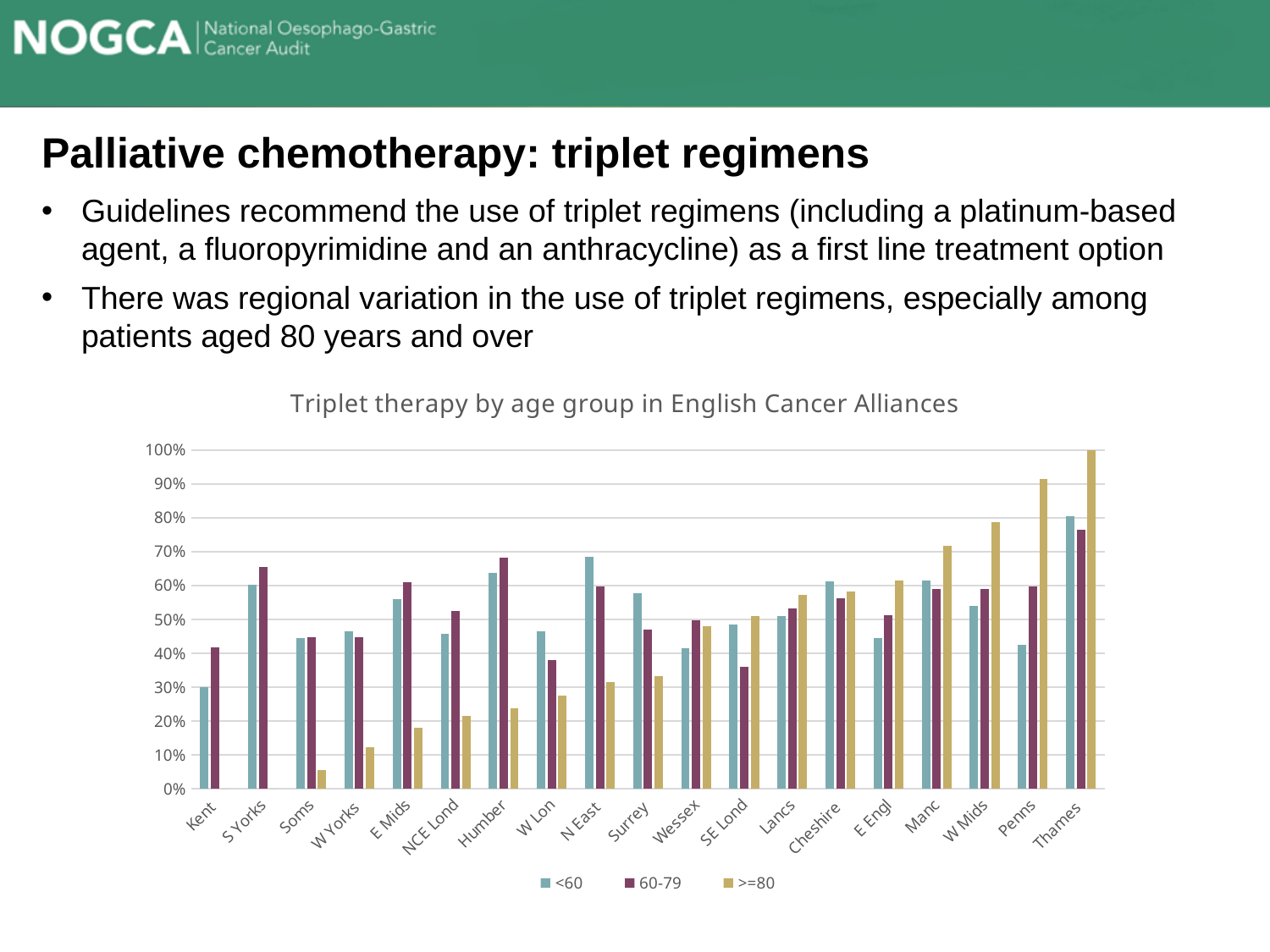
What is the title of the chart? Triplet therapy by age group in English Cancer Alliances Is the value for the <60 age group in Kent greater or less than 40%? less In Humber, which is larger: the <60 value or the >=80 value? <60 What is the value for the >=80 age group in Thames? 100% Which Cancer Alliance has the lowest value for the >=80 age group among those with a bar shown? Soms Is the value for the >=80 age group in Penns greater or less than 80%? greater How many series does the legend list? 3 What kind of chart is shown on the slide? Bar chart Do the values for the >=80 age group generally rise or fall from left to right along the x axis? rise Which Cancer Alliance has the highest value for the <60 age group? Thames Which Cancer Alliance has the highest value for the >=80 age group? Thames How many Cancer Alliances are shown on the x axis? 19